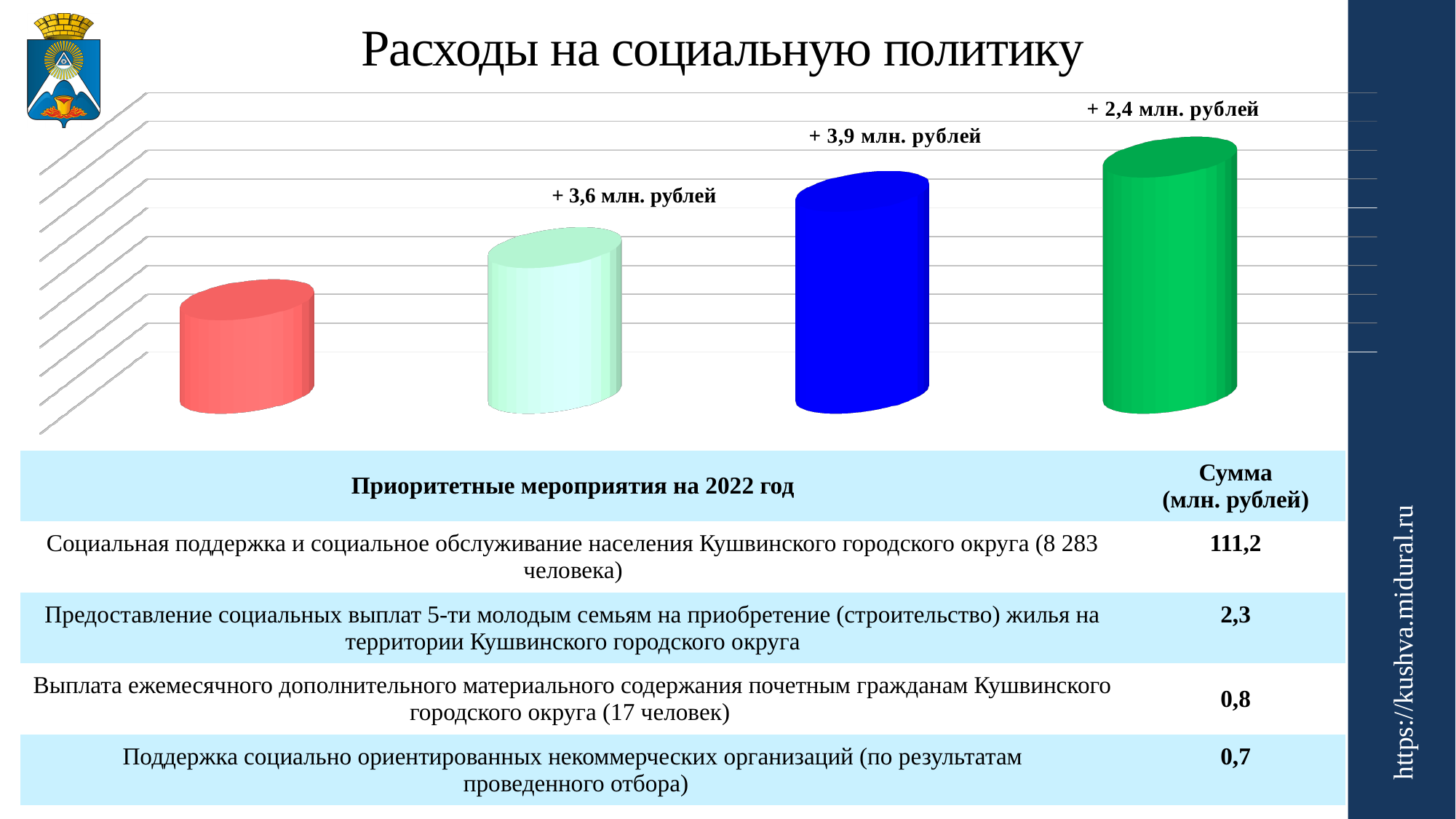
Do the bar values rise or fall from left to right across the chart? Rise How many bars does the chart contain? 4 What kind of chart is shown on the slide? Bar chart What annotation is printed above the fourth (green) bar? + 2,4 млн. рублей Which bar is the tallest in the chart? The rightmost (green) bar What is the title of the chart on the slide? Расходы на социальную политику What annotation is printed above the second (light green) bar? + 3,6 млн. рублей Is the blue (third) bar taller or shorter than the light green (second) bar? Taller What annotation is printed above the third (blue) bar? + 3,9 млн. рублей Is the red (first) bar taller or shorter than the green (fourth) bar? Shorter Which bar is the shortest in the chart? The leftmost (red) bar What colour is the third bar in the chart? Blue